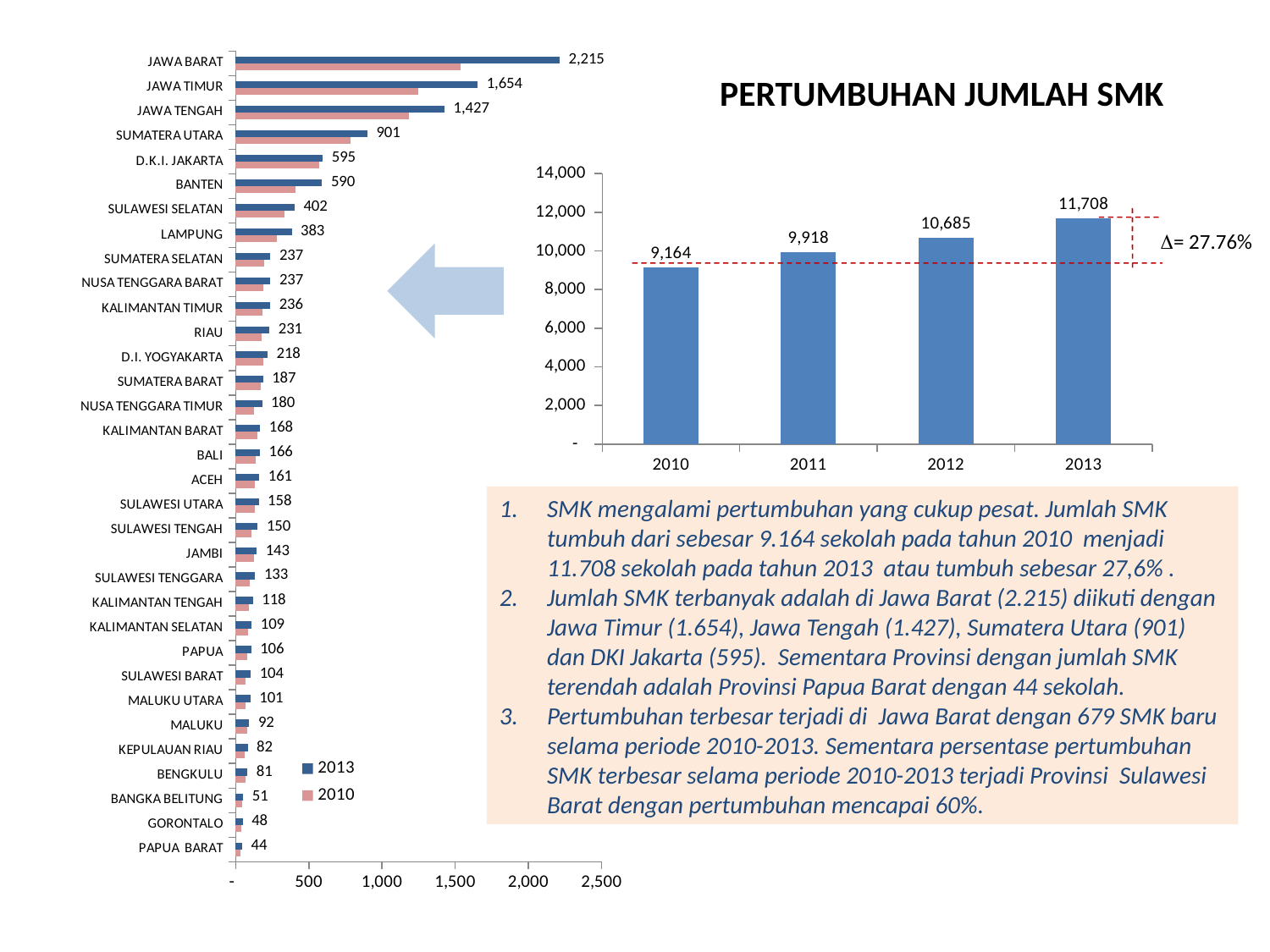
In the chart titled PERTUMBUHAN JUMLAH SMK, what is the value for 2010? 9,164 In the chart titled PERTUMBUHAN JUMLAH SMK, do the values rise or fall from 2010 to 2013? rise In the horizontal bar chart on the left, which province has the lowest 2013 value? PAPUA BARAT In the horizontal bar chart on the left, how many series does the legend list? 2 In the horizontal bar chart on the left, what is the difference between the 2013 values for JAWA TIMUR and JAWA TENGAH? 227 In the chart titled PERTUMBUHAN JUMLAH SMK, what is the difference between the 2013 and 2010 values? 2,544 In the chart titled PERTUMBUHAN JUMLAH SMK, how many years are plotted? 4 In the chart titled PERTUMBUHAN JUMLAH SMK, is the value for 2012 greater or less than 10,000? greater In the chart titled PERTUMBUHAN JUMLAH SMK, what is the value for 2013? 11,708 What kind of chart is the chart on the left? bar chart In the horizontal bar chart on the left, what is the 2013 value for JAWA BARAT? 2,215 In the horizontal bar chart on the left, what is the 2013 value for SUMATERA UTARA? 901